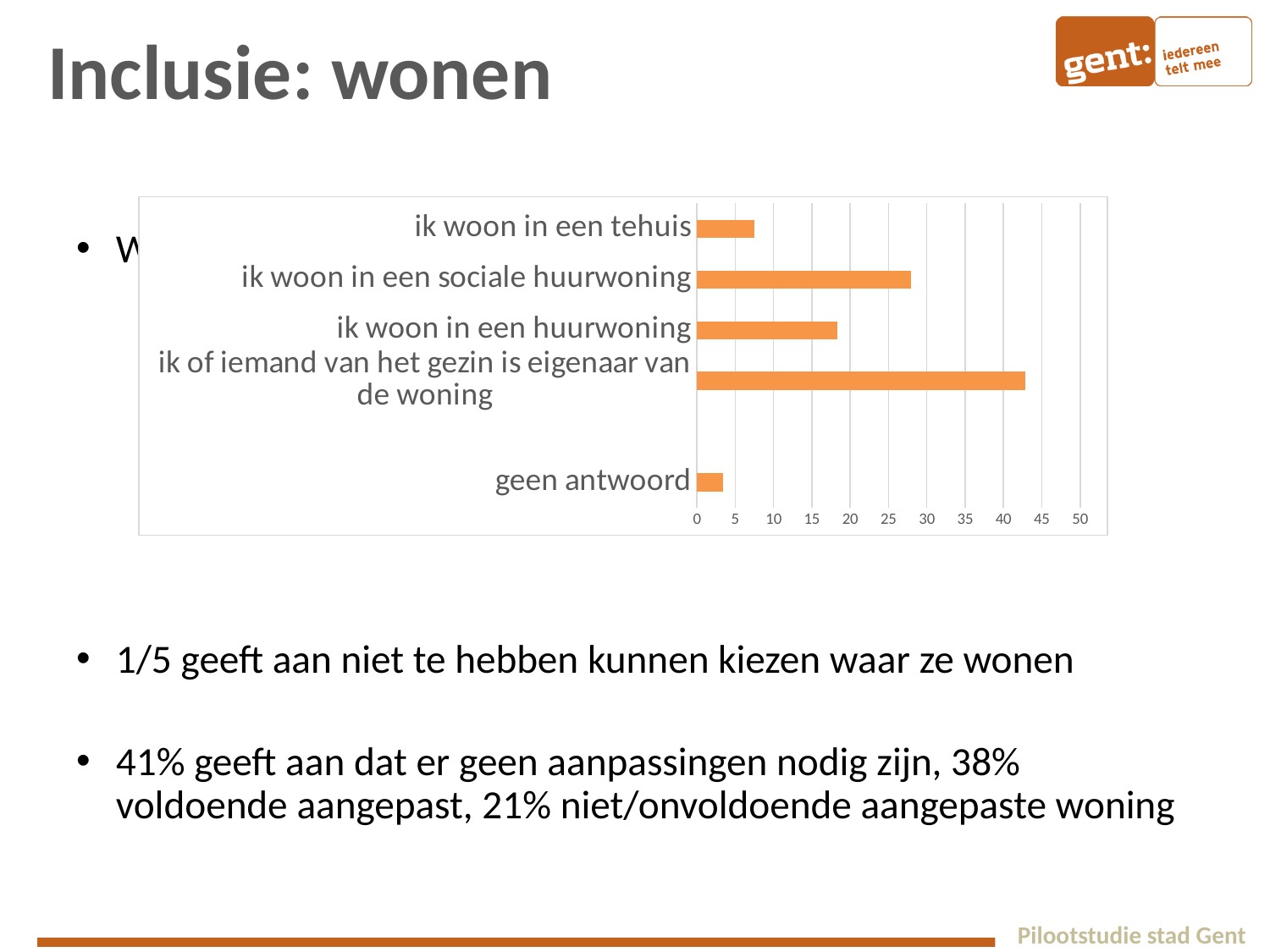
Which category has the lowest value in the chart? geen antwoord Is the value for 'geen antwoord' greater or less than 5? less Is the value for 'ik woon in een sociale huurwoning' greater or less than 25? greater Is the value for 'ik woon in een tehuis' greater or less than 10? less Which is larger: the value for 'ik woon in een sociale huurwoning' or the value for 'ik woon in een huurwoning'? ik woon in een sociale huurwoning What colour are the bars in the chart? orange How many categories does the chart show? 5 Which is larger: the value for 'ik woon in een tehuis' or the value for 'geen antwoord'? ik woon in een tehuis Which category has the highest value in the chart? ik of iemand van het gezin is eigenaar van de woning What kind of chart is shown on the slide? bar chart